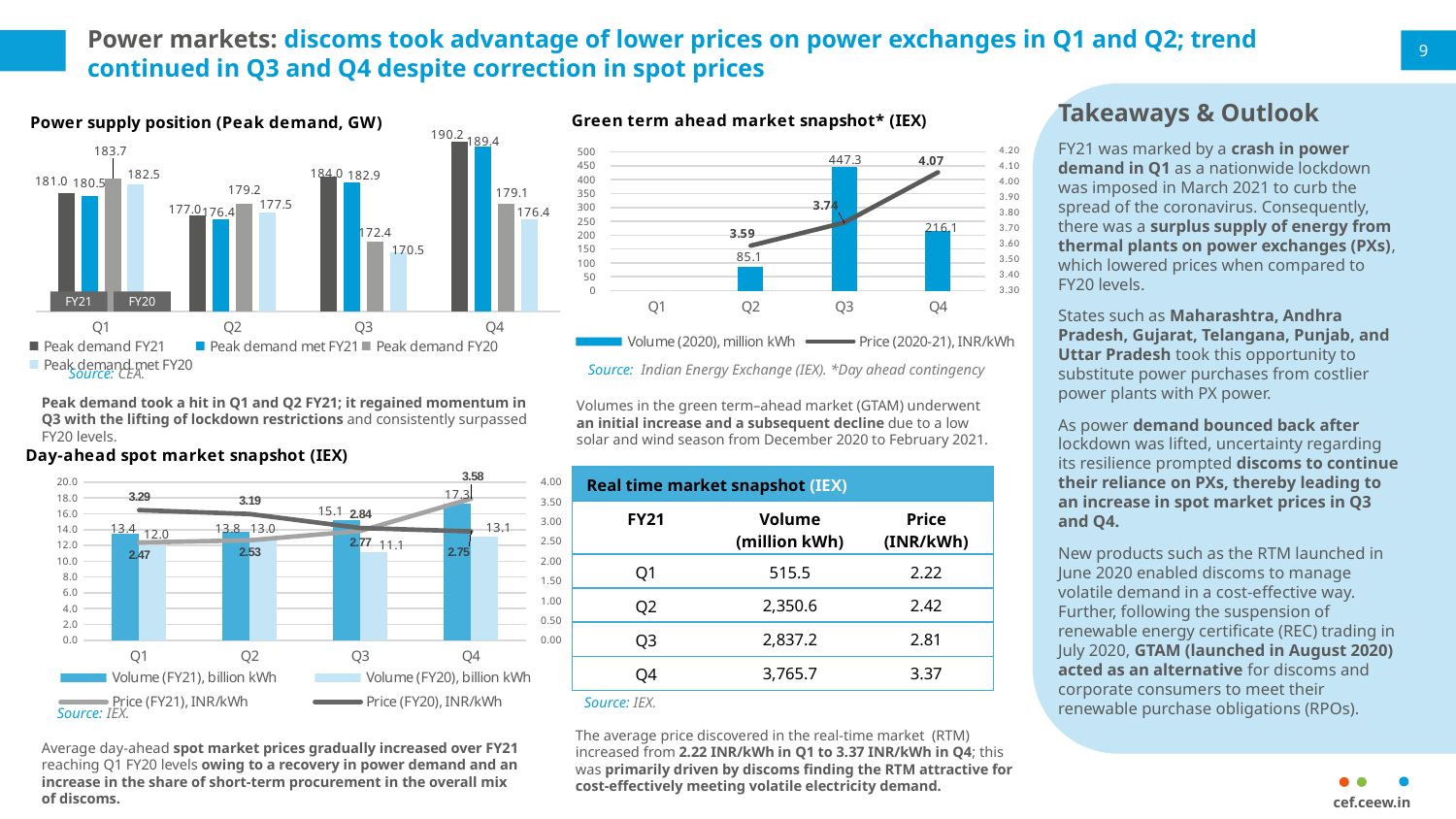
In the 'Day-ahead spot market snapshot (IEX)' chart, which quarter has the lowest Volume (FY20) value? Q3 What kind of chart is the 'Power supply position (Peak demand, GW)' chart? bar chart In the 'Green term ahead market snapshot* (IEX)' chart, what is the Price (2020-21) value for Q4? 4.07 In the 'Green term ahead market snapshot* (IEX)' chart, does the Price (2020-21) line rise or fall from Q2 to Q4? rise How many series does the legend of the 'Power supply position (Peak demand, GW)' chart list? 4 In the 'Day-ahead spot market snapshot (IEX)' chart, what is the Volume (FY21) value for Q4? 17.3 In the 'Power supply position (Peak demand, GW)' chart, what is the difference between Peak demand FY21 and Peak demand met FY21 in Q3? 1.1 In the 'Power supply position (Peak demand, GW)' chart, what is the Peak demand FY21 value for Q4? 190.2 In the 'Power supply position (Peak demand, GW)' chart, which quarter has the highest Peak demand FY21 value? Q4 In the 'Day-ahead spot market snapshot (IEX)' chart, what is the difference between Volume (FY21) and Volume (FY20) in Q3? 4.0 In the 'Day-ahead spot market snapshot (IEX)' chart, which is larger in Q1: Price (FY21) or Price (FY20)? Price (FY20) In the 'Green term ahead market snapshot* (IEX)' chart, what is the Volume (2020) value for Q3? 447.3